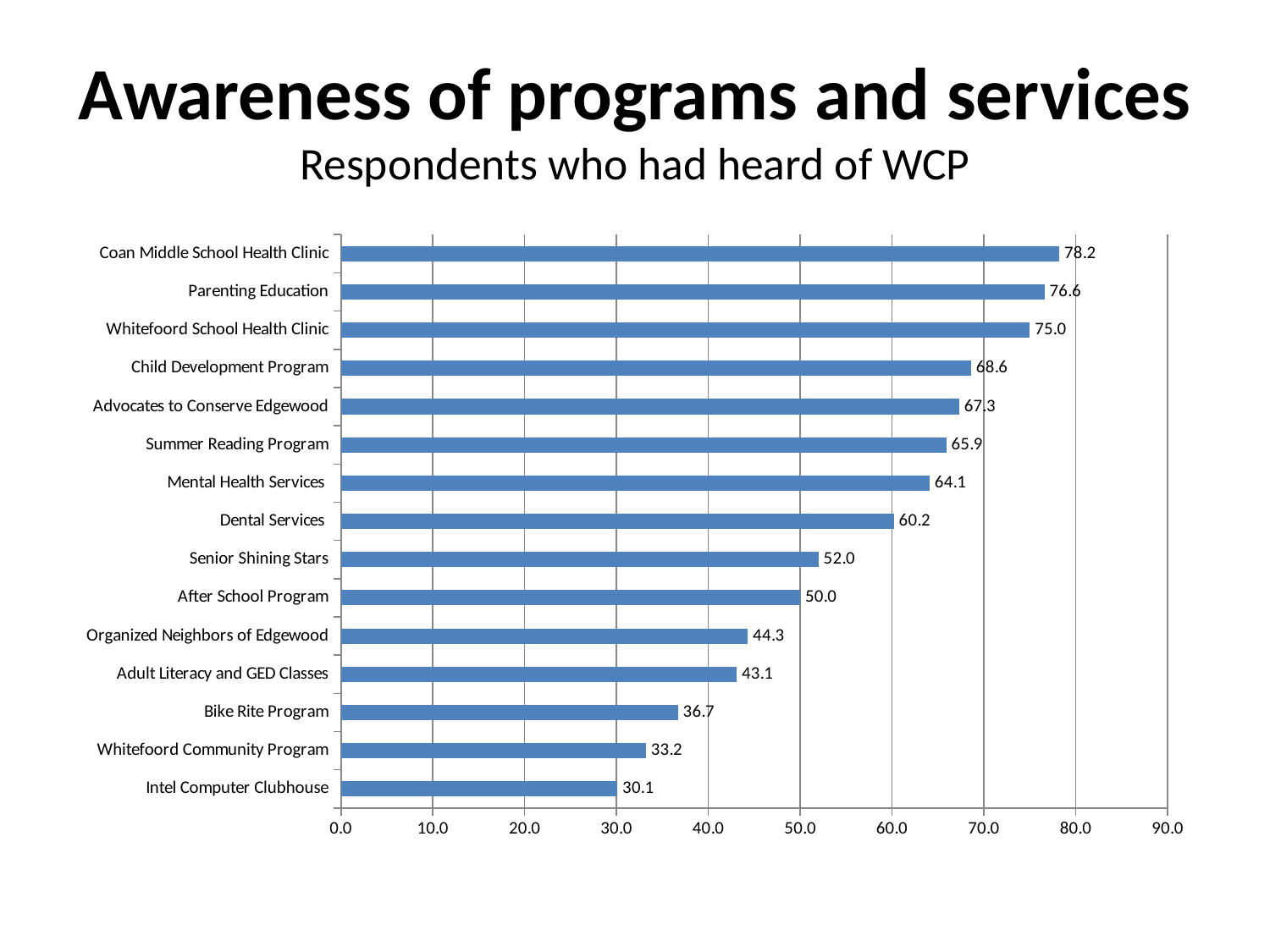
What is the difference between the values for Parenting Education and Whitefoord School Health Clinic? 1.6 What is the difference between the values for Senior Shining Stars and After School Program? 2.0 Which program or service has the lowest value? Intel Computer Clubhouse How many programs or services are shown in the chart? 15 What is the value for Coan Middle School Health Clinic? 78.2 What kind of chart is shown on the slide? bar chart What is the value for Dental Services? 60.2 What is the subtitle of the chart on the slide? Respondents who had heard of WCP Which program or service has the highest value? Coan Middle School Health Clinic What is the value for Bike Rite Program? 36.7 Which is larger, the value for Mental Health Services or the value for Summer Reading Program? Summer Reading Program Is the value for Child Development Program greater or less than 70.0? less